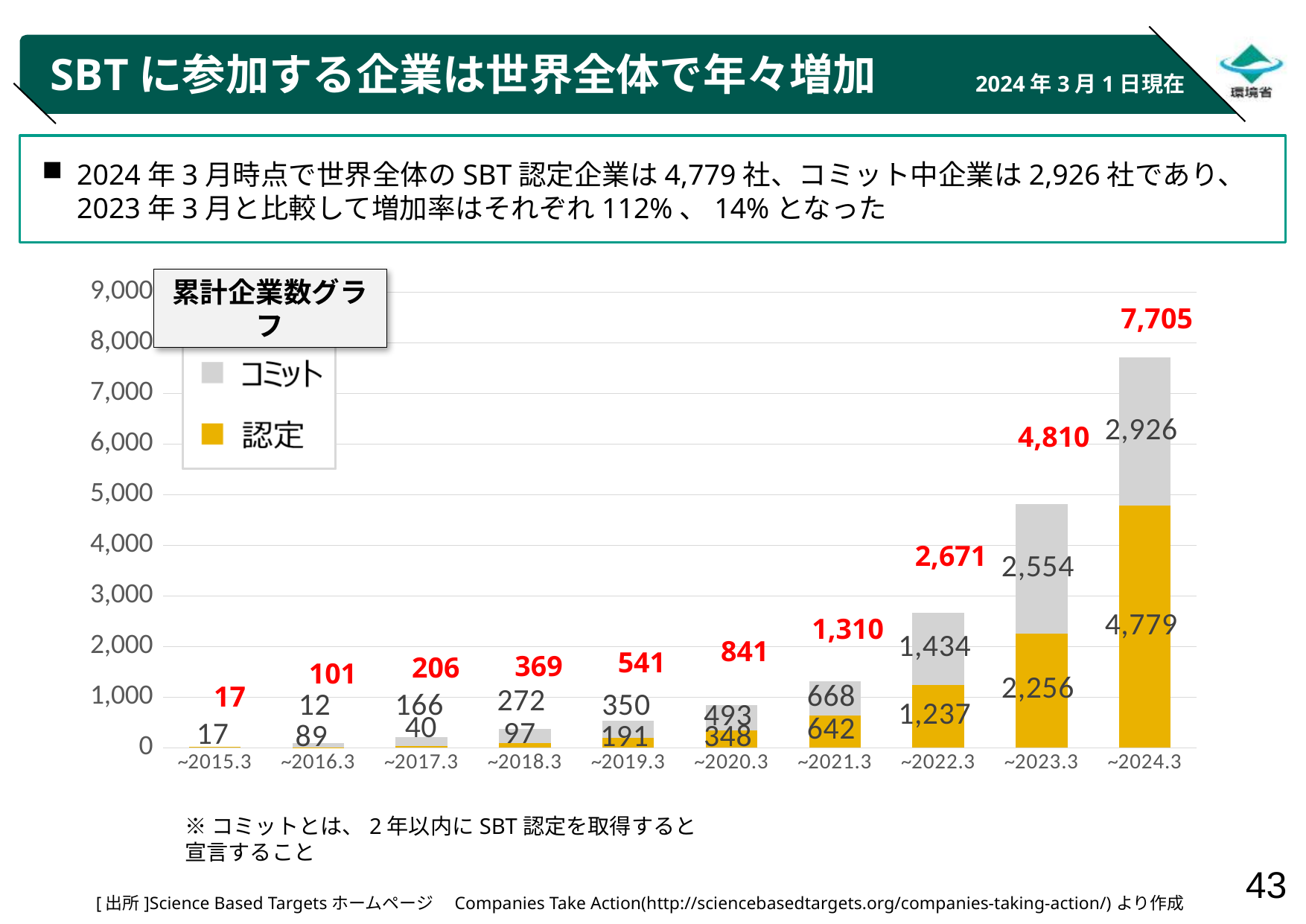
Which category has the lowest total? ~2015.3 How many series does the legend list? 2 Which colour represents the 認定 series? gold (yellow) What is the total of the stacked bar for ~2022.3? 2,671 Which category has the highest total? ~2024.3 What is the コミット value for ~2023.3? 2,554 What type of chart is shown on the slide? stacked bar chart Do the totals rise or fall from ~2015.3 to ~2024.3? rise Which is larger for ~2021.3, the コミット value or the 認定 value? コミット What is the difference between the 認定 values for ~2024.3 and ~2023.3? 2,523 How many categories are shown on the x axis? 10 What is the 認定 value for ~2024.3? 4,779